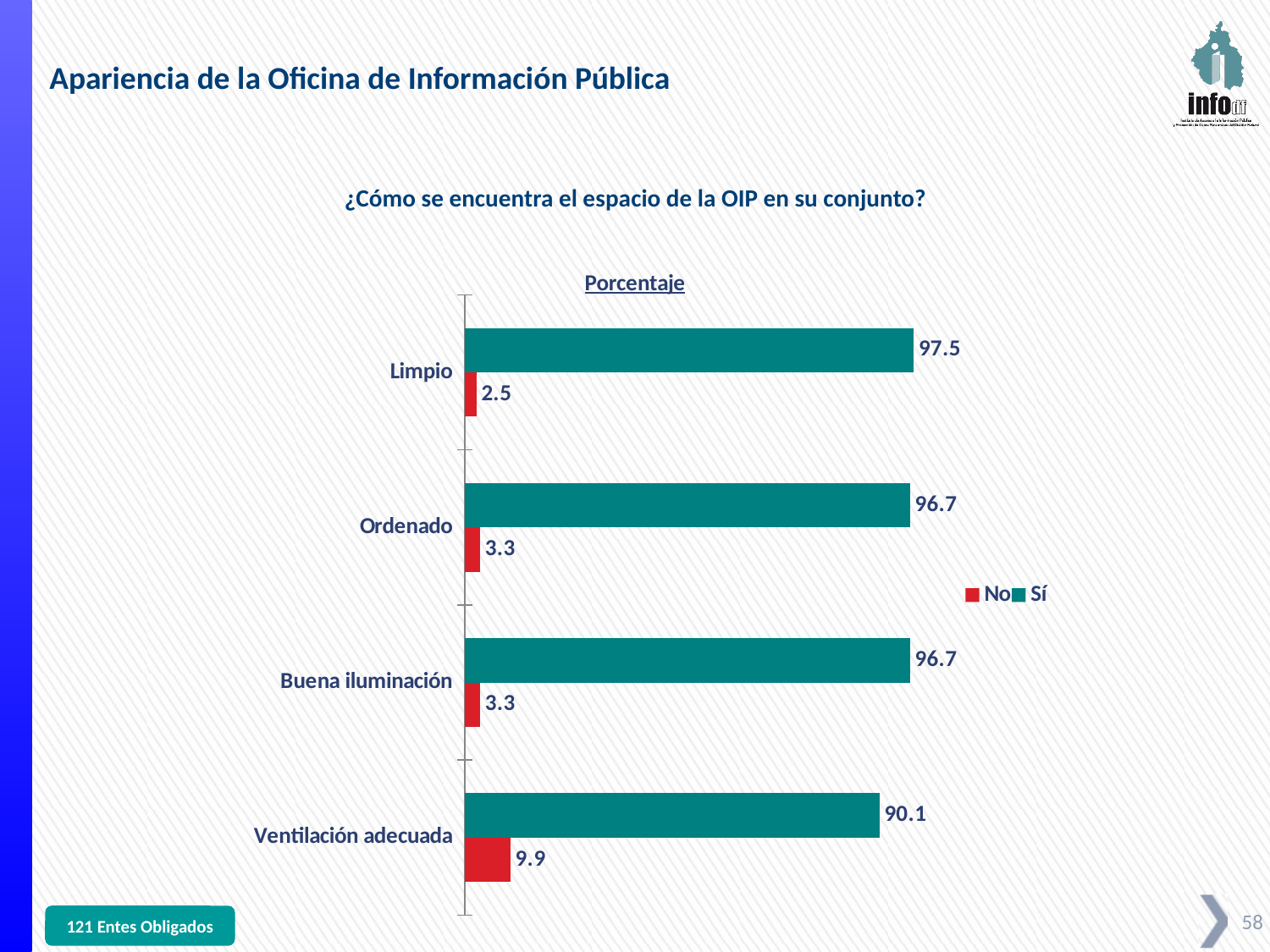
What is the 'Sí' value for Ordenado? 96.7 Which category has the highest 'No' value? Ventilación adecuada How many categories are shown in the chart? 4 What is the 'No' value for Buena iluminación? 3.3 How many series does the legend list? 2 What kind of chart is shown on the slide? Bar chart Which category has the highest 'Sí' value? Limpio Which category has the lowest 'Sí' value? Ventilación adecuada What is the 'No' value for Ventilación adecuada? 9.9 What is the 'Sí' value for Limpio? 97.5 What is the difference between the 'Sí' value for Limpio and the 'Sí' value for Ventilación adecuada? 7.4 Which is larger: the 'No' value for Ventilación adecuada or the 'No' value for Limpio? Ventilación adecuada